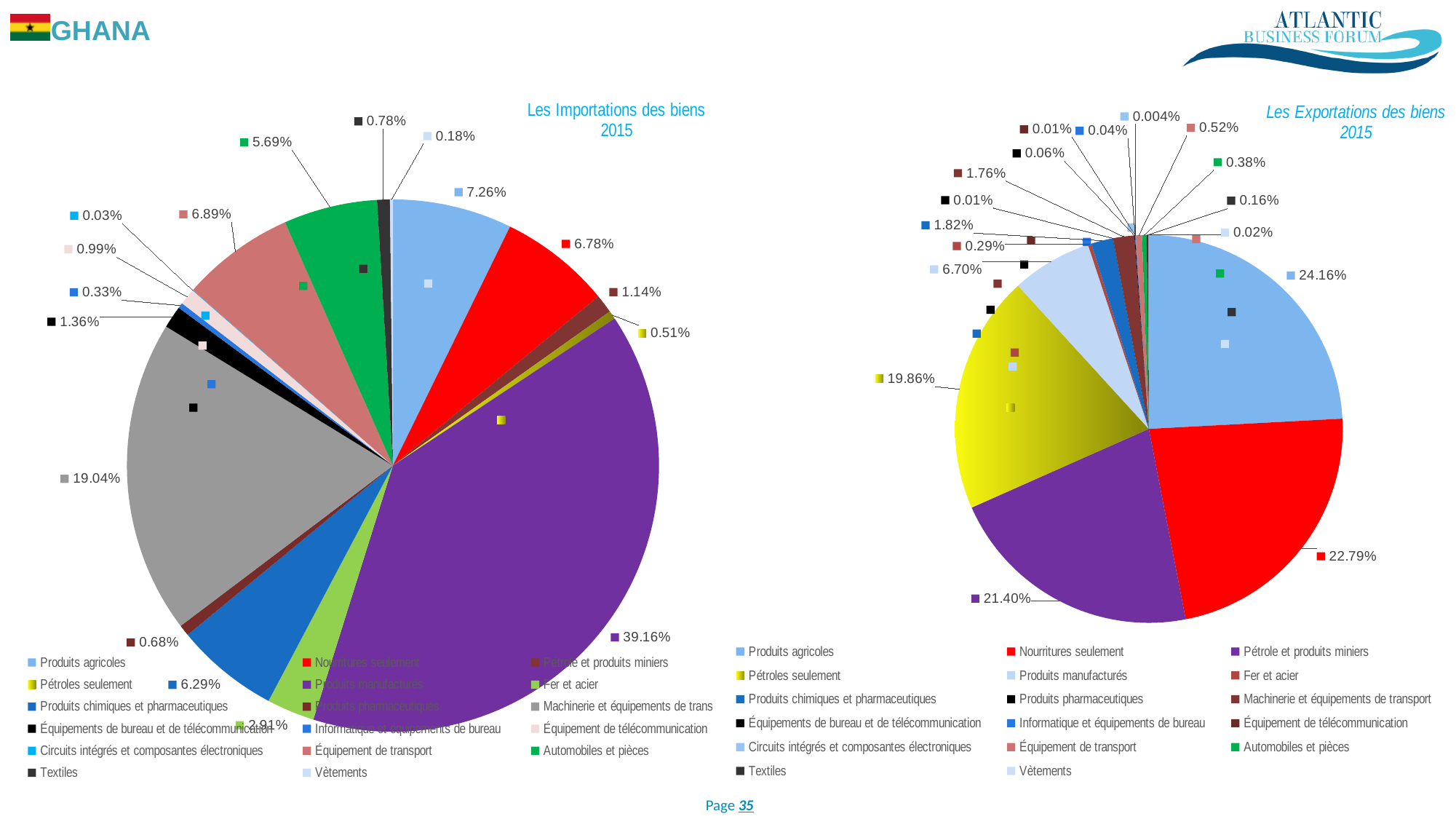
In the 'Les Importations des biens 2015' chart, what is the value for Produits agricoles? 7.26% In the 'Les Importations des biens 2015' chart, what share does Produits manufacturés have? 39.16% In the 'Les Exportations des biens 2015' chart, what is the difference between Produits agricoles and Nourritures seulement? 1.37% In the 'Les Exportations des biens 2015' chart, what is the value for Pétrole et produits miniers? 21.40% What type of charts are shown on the slide? Pie charts In the 'Les Importations des biens 2015' chart, what is the value for Machinerie et équipements de transport? 19.04% In the 'Les Importations des biens 2015' chart, which category has the largest share? Produits manufacturés In the 'Les Exportations des biens 2015' chart, which category has the largest share? Produits agricoles In the 'Les Importations des biens 2015' chart, what is the difference between Produits agricoles and Nourritures seulement? 0.48% In the 'Les Exportations des biens 2015' chart, what is the value for Nourritures seulement? 22.79% How many categories does the legend of the 'Les Exportations des biens 2015' chart list? 17 In the 'Les Exportations des biens 2015' chart, which is larger: Pétroles seulement or Produits manufacturés? Pétroles seulement